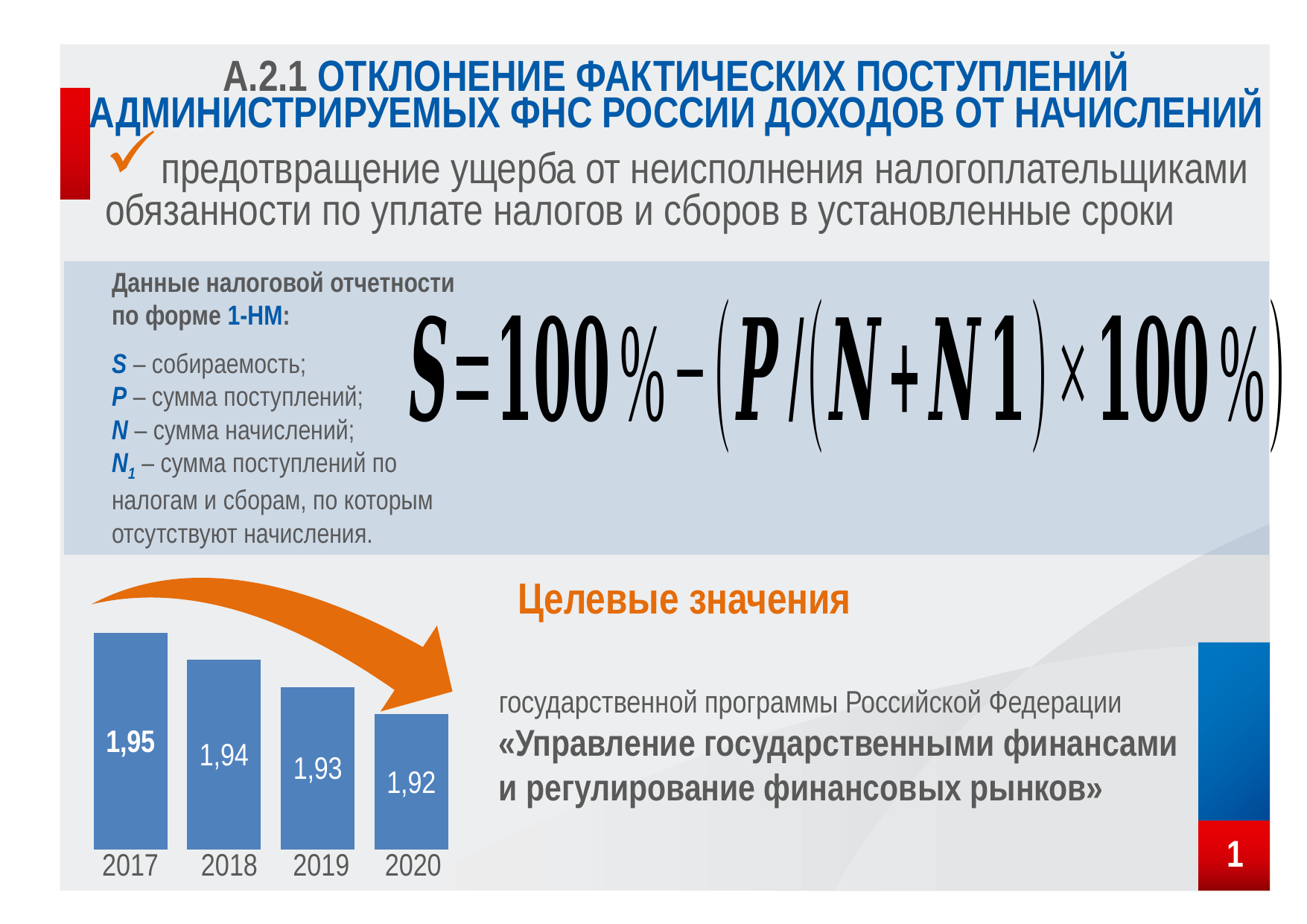
What is the value shown for 2017? 1,95 What is the value shown for 2019? 1,93 Which year has the lowest value in the chart? 2020 What is the value shown for 2018? 1,94 Which is larger, the value for 2018 or the value for 2019? 2018 Which year has the highest value in the chart? 2017 What is the difference between the values for 2017 and 2020? 0,03 What is the value shown for 2020? 1,92 Do the values rise or fall from 2017 to 2020? fall What colour are the bars in the chart? blue How many years are shown in the chart? 4 What kind of chart is shown on the slide? bar chart